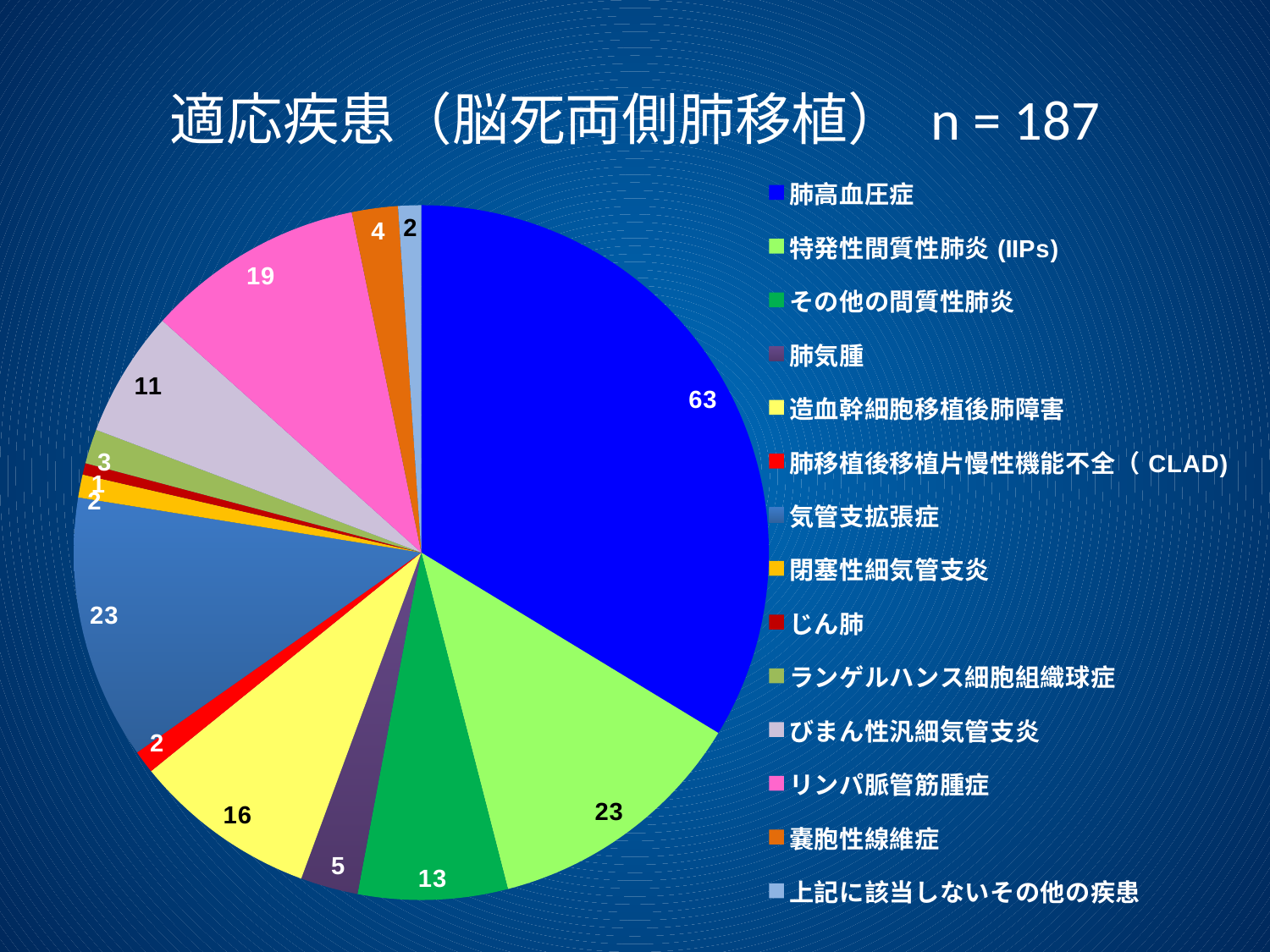
What colour is the slice for 嚢胞性線維症? orange What is the value for リンパ脈管筋腫症? 19 Which category has the smallest slice of the pie? じん肺 Which is larger, the value for その他の間質性肺炎 or the value for 肺気腫? その他の間質性肺炎 What kind of chart is shown on the slide? pie chart What is the value for びまん性汎細気管支炎? 11 What is the value for 造血幹細胞移植後肺障害? 16 Which category has the largest slice of the pie? 肺高血圧症 How many categories does the legend list? 14 What is the total n shown in the chart title? 187 What is the difference between the values for 肺高血圧症 and 特発性間質性肺炎 (IIPs)? 40 What is the value for 肺高血圧症? 63